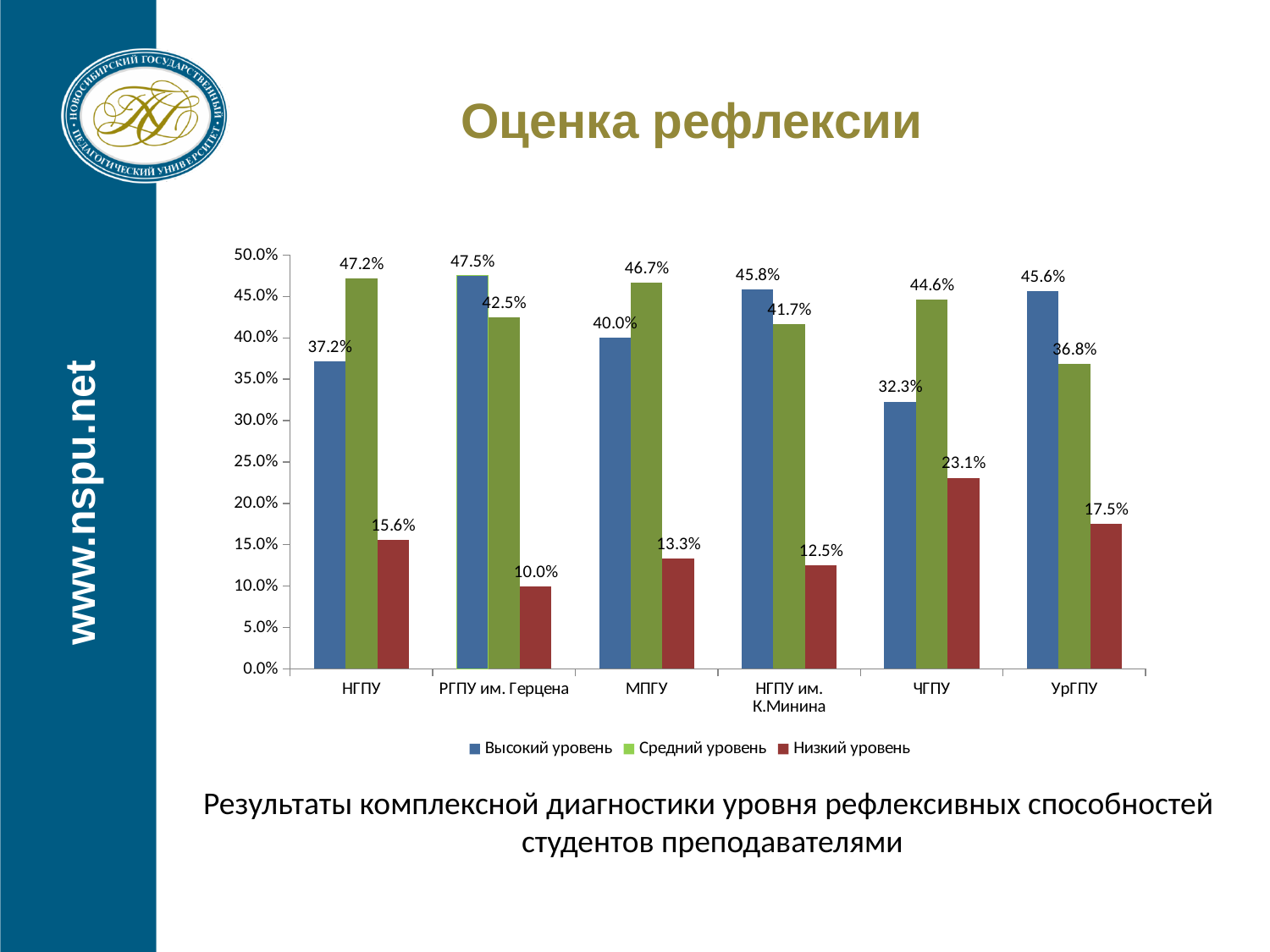
Which is larger for НГПУ им. К.Минина: Высокий уровень or Средний уровень? Высокий уровень How many series does the legend list? 3 What is the difference between Средний уровень and Высокий уровень for УрГПУ? 8.8% What is the value of Низкий уровень for ЧГПУ? 23.1% Which category has the lowest value for Высокий уровень? ЧГПУ What is the title of the slide above the chart? Оценка рефлексии What kind of chart is shown on the slide? Bar chart Which category has the lowest value for Низкий уровень? РГПУ им. Герцена How many categories are shown on the x axis? 6 What is the value of Высокий уровень for НГПУ? 37.2% What is the value of Средний уровень for МПГУ? 46.7% Which category has the highest value for Высокий уровень? РГПУ им. Герцена